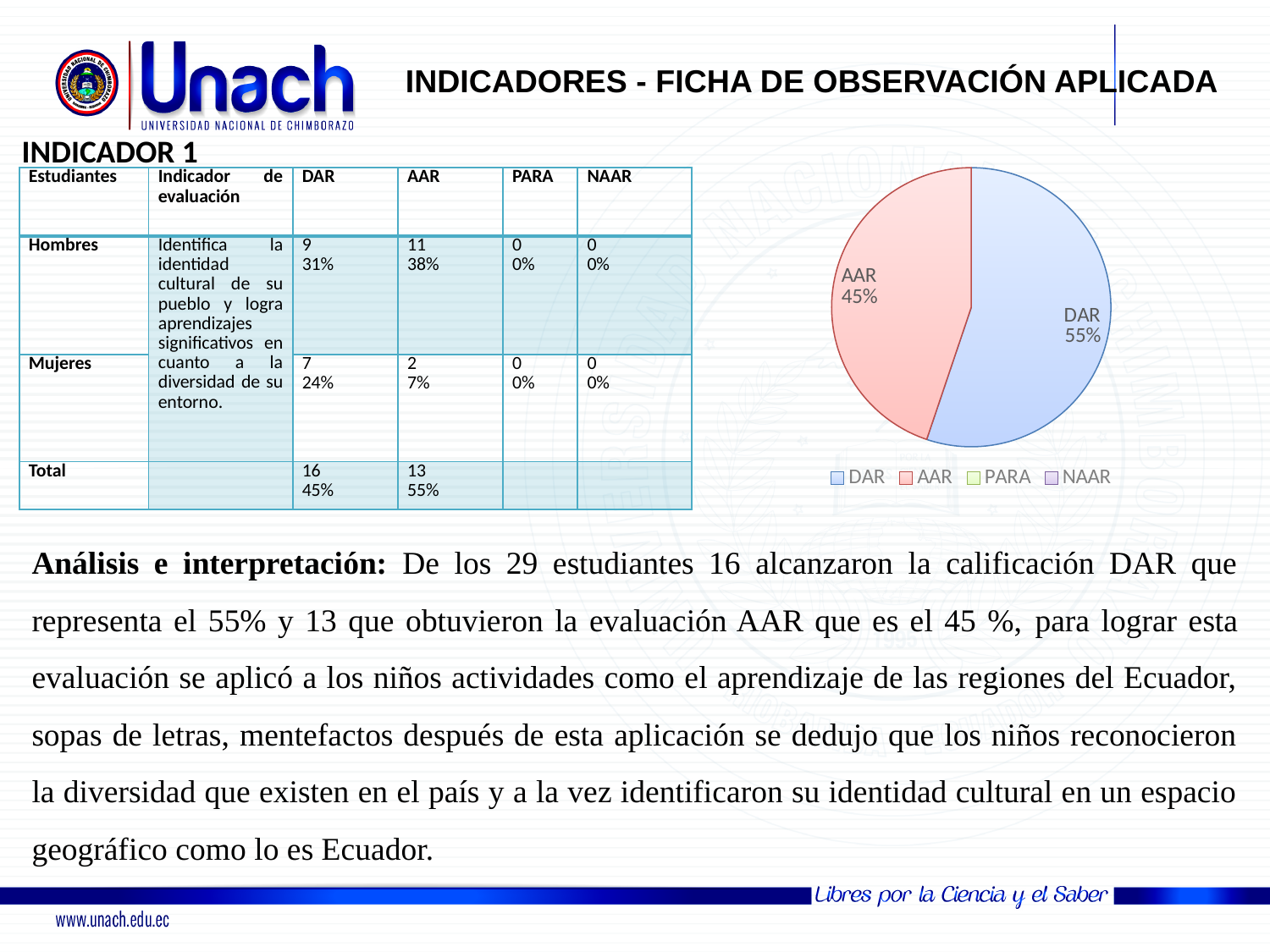
What share of the pie chart does DAR represent? 55% How many entries does the legend of the pie chart list? 4 Which category has the largest slice in the pie chart? DAR What kind of chart is shown on the slide? pie chart What is the difference in percentage points between the DAR slice and the AAR slice? 10% Is the share for AAR greater or less than 50%? less What share of the pie chart does AAR represent? 45% Is the share for DAR greater or less than 50%? greater Which of the two labelled slices is larger, DAR or AAR? DAR What colour is the DAR slice in the pie chart? blue Which legend entries of the pie chart do not appear as visible slices? PARA and NAAR How many slices have a visible data label in the pie chart? 2